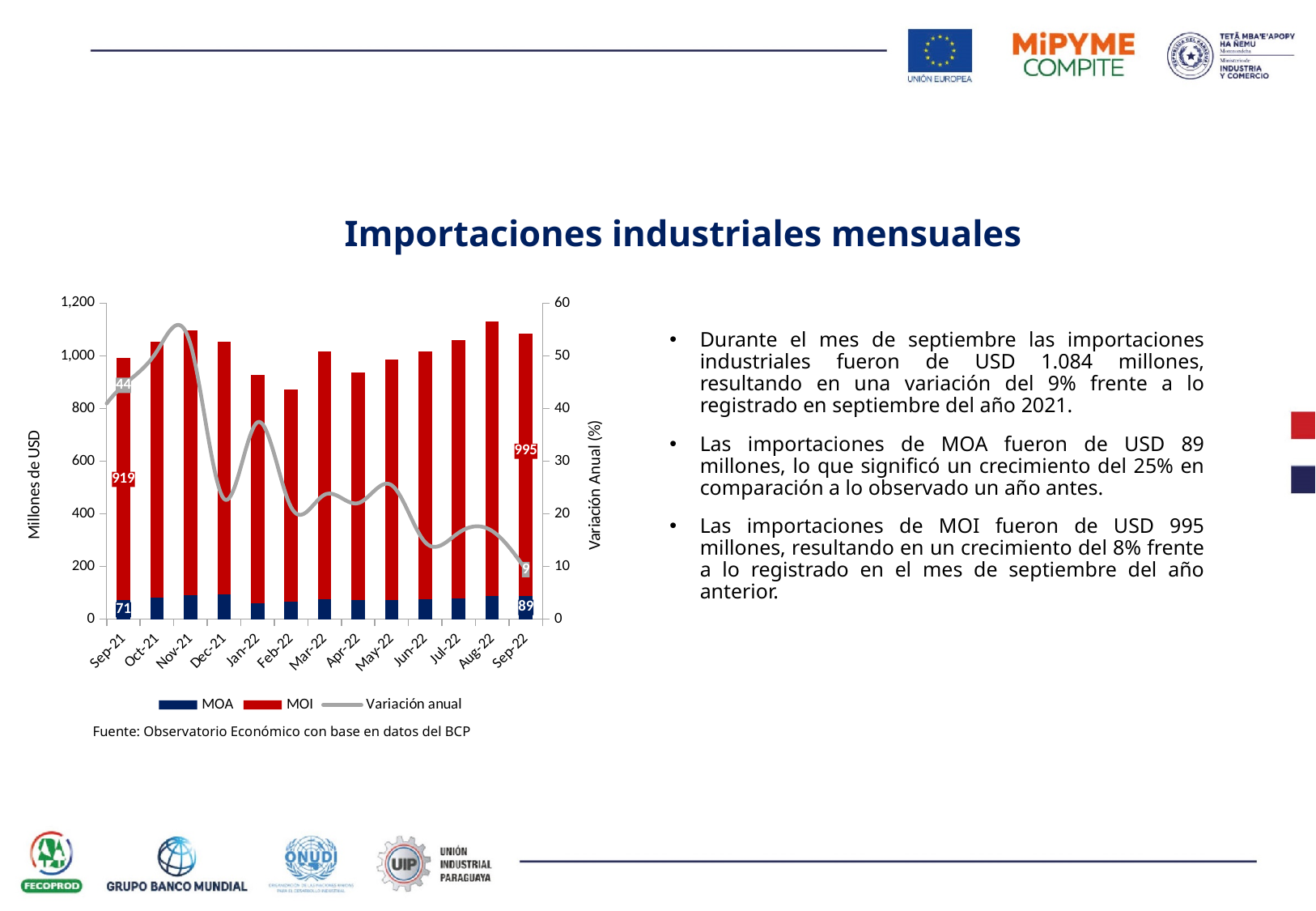
Which is larger, the MOA value for Sep-22 or the MOA value for Sep-21? Sep-22 Which month has the lowest total bar? Feb-22 Does the Variación anual line rise or fall between Sep-21 and Sep-22? fall What is the Variación anual value for Sep-22? 9 What is the MOA value for Sep-21? 71 What is the title of the chart? Importaciones industriales mensuales What is the MOI value for Sep-22? 995 How many series does the legend list? 3 What is the total of the stacked bar for Sep-22 (MOA plus MOI)? 1,084 Is the total bar for Jan-22 greater or less than 1,000? less How many months are shown on the x axis? 13 What is the difference between the MOI value for Sep-22 and the MOI value for Sep-21? 76